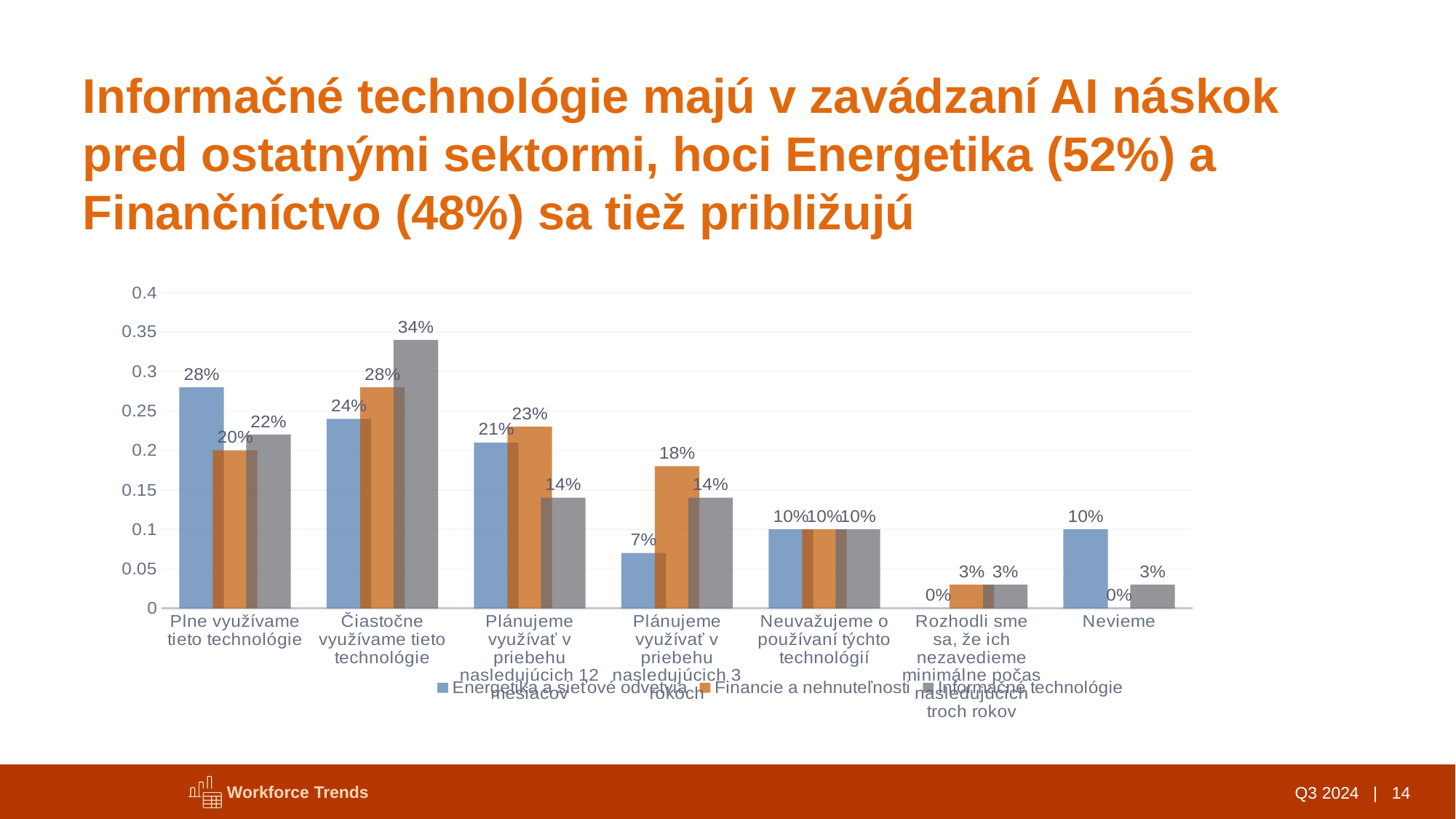
Which category has the lowest value for the Energetika a sieťové odvetvia series? Rozhodli sme sa, že ich nezavedieme minimálne počas nasledujúcich troch rokov What is the value for Energetika a sieťové odvetvia in the category "Plne využívame tieto technológie"? 28% How many categories are shown on the x axis of the chart? 7 What is the value for Energetika a sieťové odvetvia in the category "Nevieme"? 10% What is the value for Informačné technológie in the category "Čiastočne využívame tieto technológie"? 34% In the category "Plánujeme využívať v priebehu nasledujúcich 3 rokoch", which series has the larger value: Energetika a sieťové odvetvia or Financie a nehnuteľnosti? Financie a nehnuteľnosti What kind of chart is shown on the slide? Bar chart What is the difference between the Informačné technológie value and the Energetika a sieťové odvetvia value in the category "Čiastočne využívame tieto technológie"? 10% What is the value for Financie a nehnuteľnosti in the category "Plánujeme využívať v priebehu nasledujúcich 3 rokoch"? 18% Which series is shown in orange in the chart? Financie a nehnuteľnosti Which category has the highest value for the Informačné technológie series? Čiastočne využívame tieto technológie How many series does the chart's legend list? 3